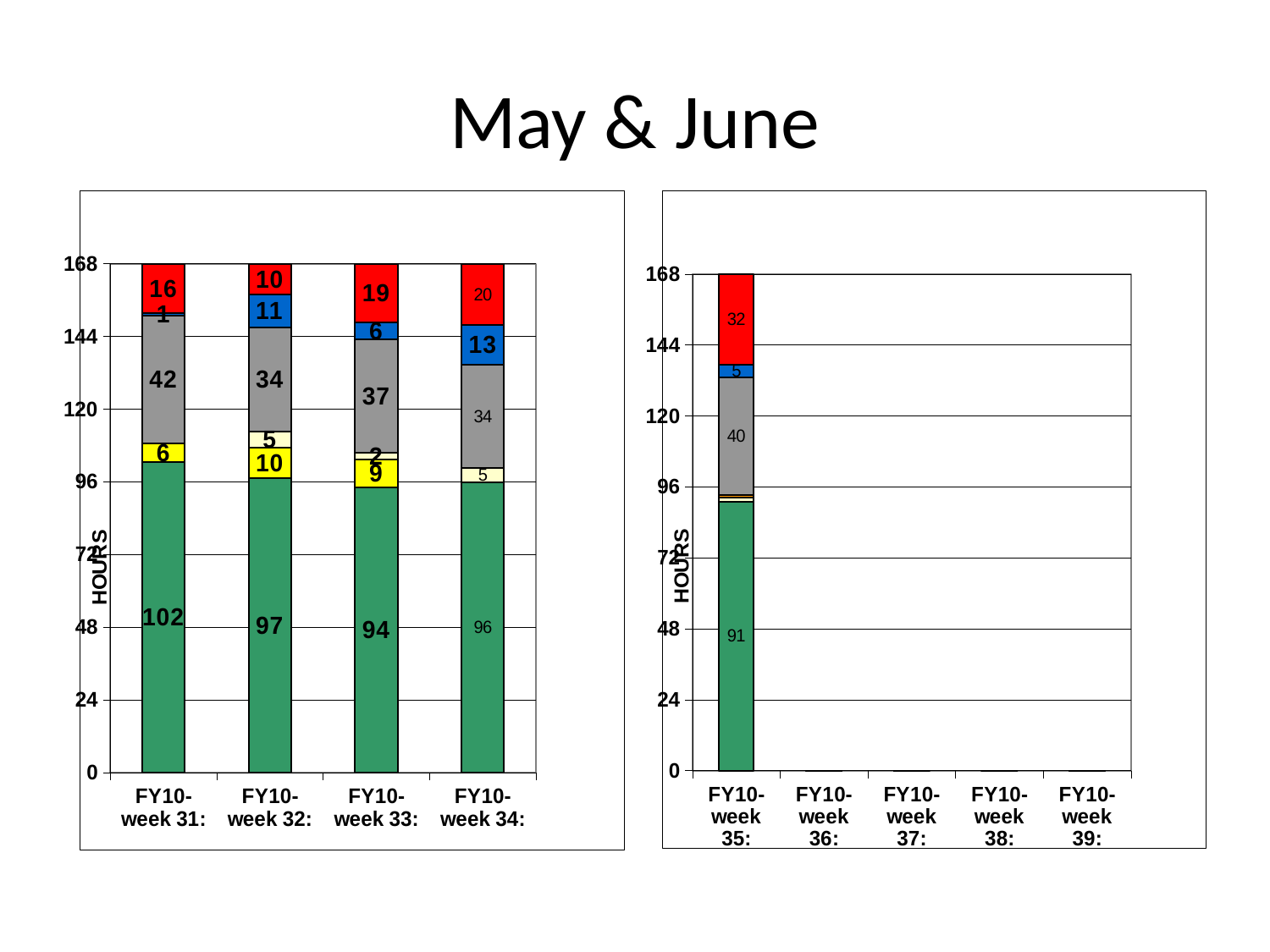
What type of chart is the left chart? Stacked bar chart How many week categories are shown on the x axis of the left chart? 4 In the right chart, what is the value of the green (bottom) segment for FY10-week 35? 91 In the left chart, what is the value of the blue segment for FY10-week 34? 13 In the left chart, what is the value of the green (bottom) segment for FY10-week 31? 102 In the right chart, what is the total of the stacked bar for FY10-week 35? 168 In the left chart, what is the value of the gray segment for FY10-week 32? 34 In the left chart, what is the value of the red (top) segment for FY10-week 33? 19 In the left chart, what is the difference between the green segment values for FY10-week 31 and FY10-week 32? 5 In the right chart, what is the value of the red (top) segment for FY10-week 35? 32 In the left chart, which week has the largest green (bottom) segment? FY10-week 31 In the left chart, which has the larger red segment, FY10-week 33 or FY10-week 34? FY10-week 34